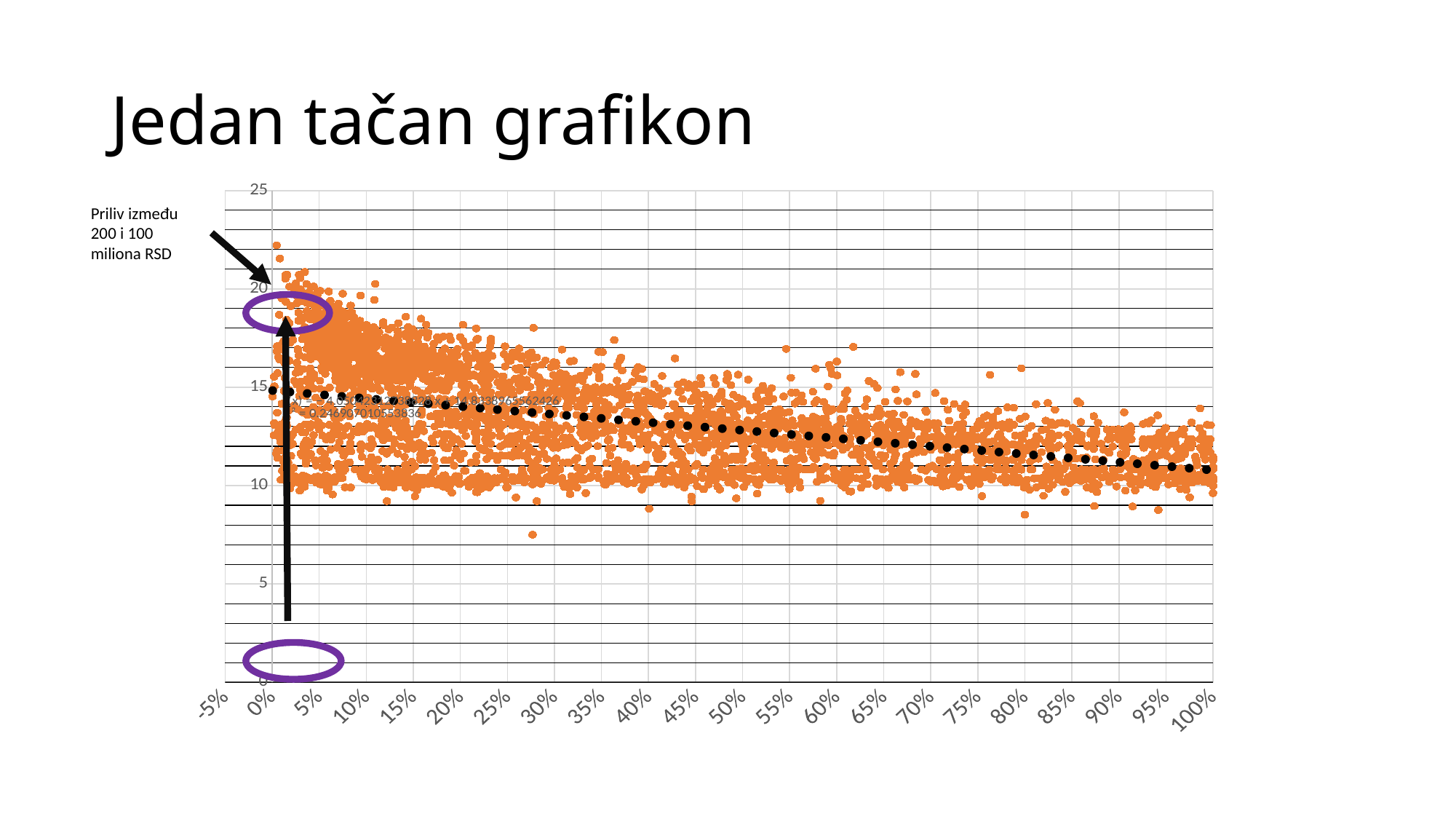
Does the dotted trendline rise or fall as the x-axis values increase from 0% to 100%? fall What is the highest label shown on the horizontal axis? 100% Is the dotted trendline value at 0% greater or less than 10? greater Is the trendline value at 0% larger or smaller than the trendline value at 100%? larger Is the dotted trendline value at 0% greater or less than 20? less What kind of chart is shown on the slide? scatter chart What is the highest value shown on the vertical axis? 25 What is the title of the slide containing the chart? Jedan tačan grafikon Is the dotted trendline value at 100% greater or less than 15? less